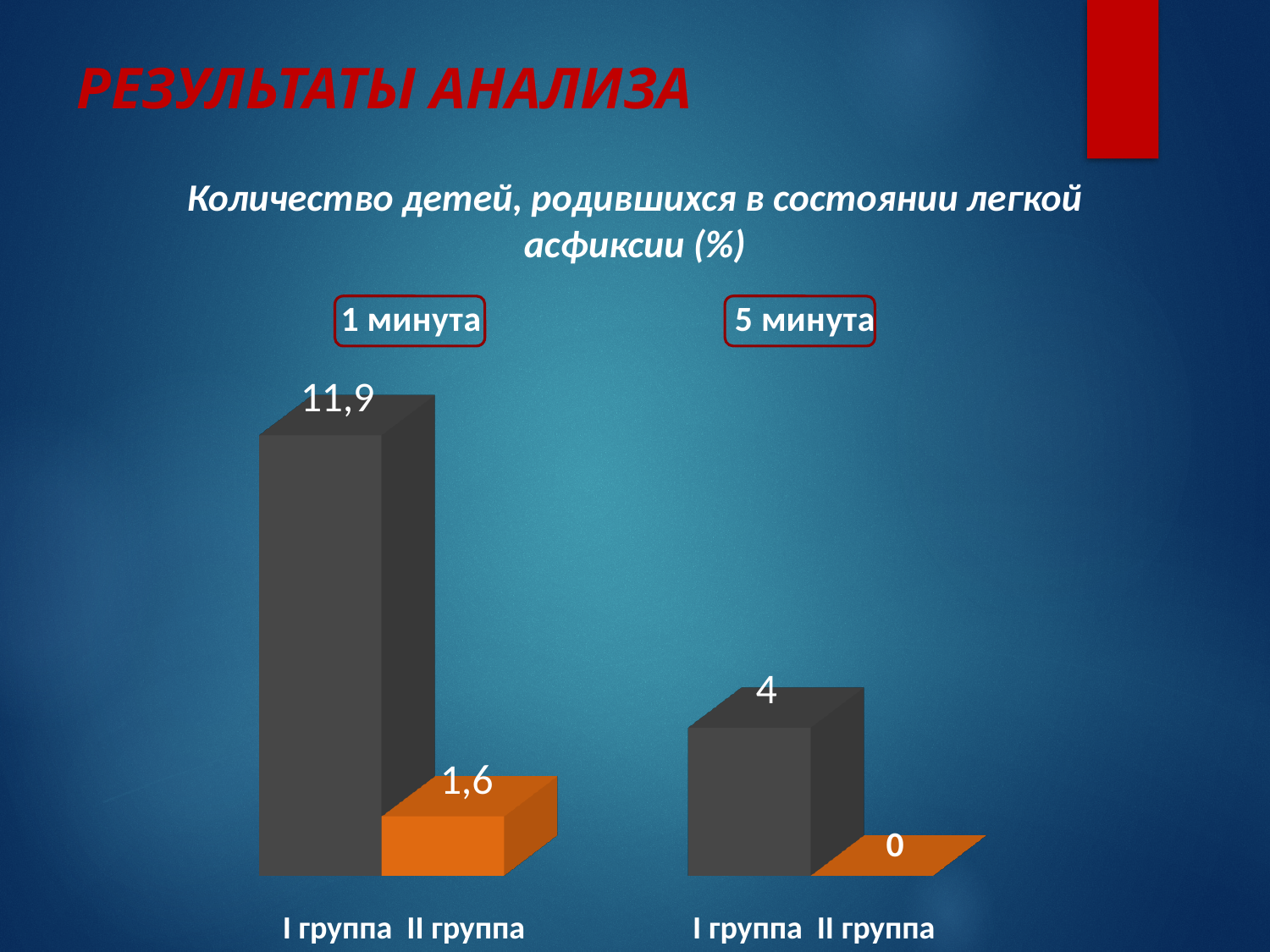
What is the title of the chart? Количество детей, родившихся в состоянии легкой асфиксии (%) What is the difference between I группа at 1 минута and I группа at 5 минута? 7,9 What kind of chart is shown on the slide? Bar chart How many bars are plotted on the chart in total? 4 Which bar has the lowest value on the chart? II группа at 5 минута What is the value for I группа at 5 минута? 4 What is the value for II группа at 5 минута? 0 What is the value for I группа at 1 минута? 11,9 What is the difference between I группа and II группа at 1 минута? 10,3 Which is larger: I группа at 5 минута or II группа at 1 минута? I группа at 5 минута What is the value for II группа at 1 минута? 1,6 Which bar has the highest value on the chart? I группа at 1 минута